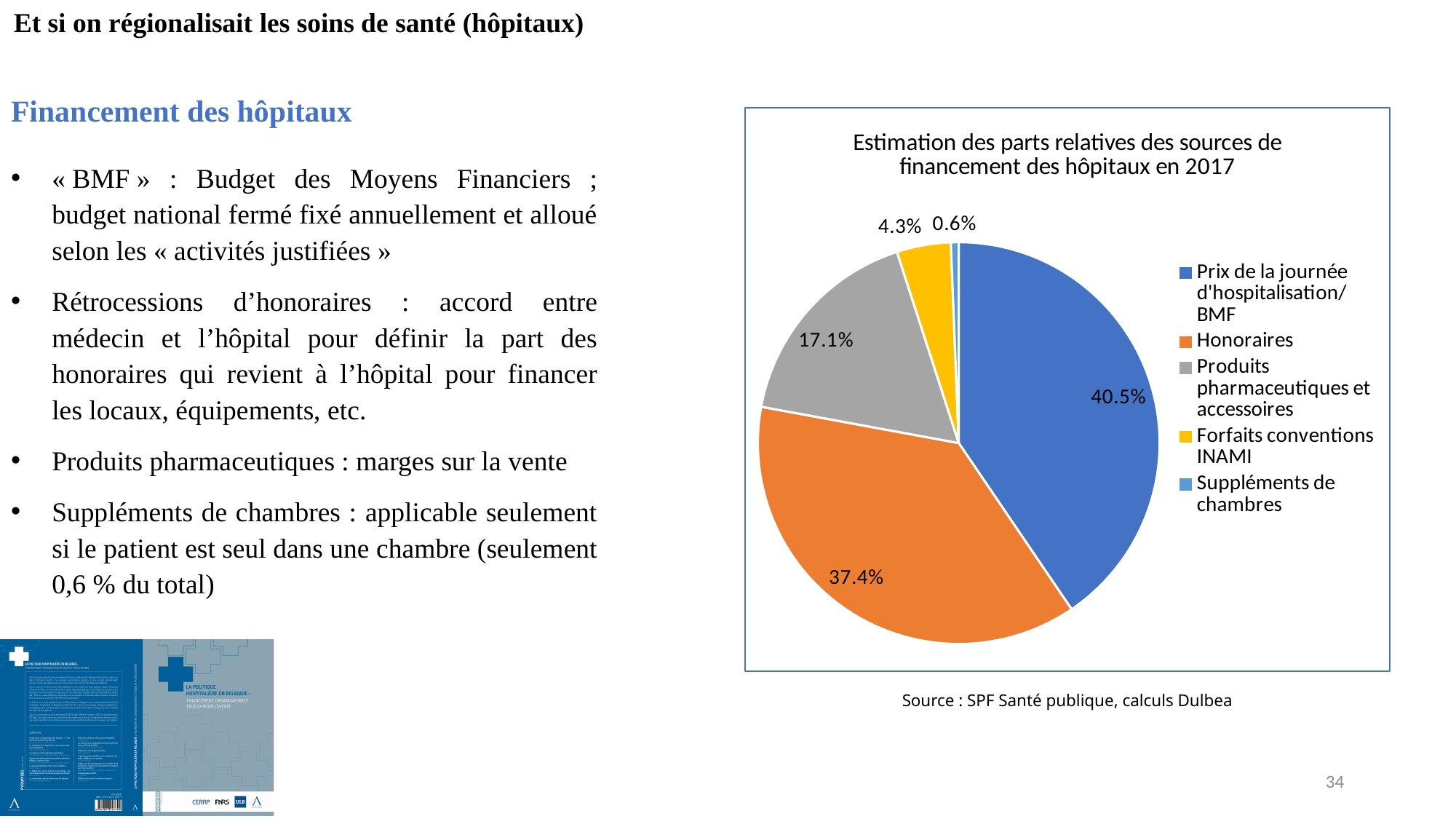
How many categories does the legend list? 5 Which source of financing has the smallest share? Suppléments de chambres What share of hospital financing comes from Honoraires? 37.4% What share is shown for Produits pharmaceutiques et accessoires? 17.1% What share is shown for Suppléments de chambres? 0.6% What share is shown for Forfaits conventions INAMI? 4.3% Which is larger: the share for Produits pharmaceutiques et accessoires or the share for Forfaits conventions INAMI? Produits pharmaceutiques et accessoires What is the difference in percentage points between Prix de la journée d'hospitalisation/BMF and Honoraires? 3.1 What type of chart is shown on the slide? pie chart What share is shown for Prix de la journée d'hospitalisation/BMF? 40.5% What is the title of the chart? Estimation des parts relatives des sources de financement des hôpitaux en 2017 Which source of financing has the largest share? Prix de la journée d'hospitalisation/BMF